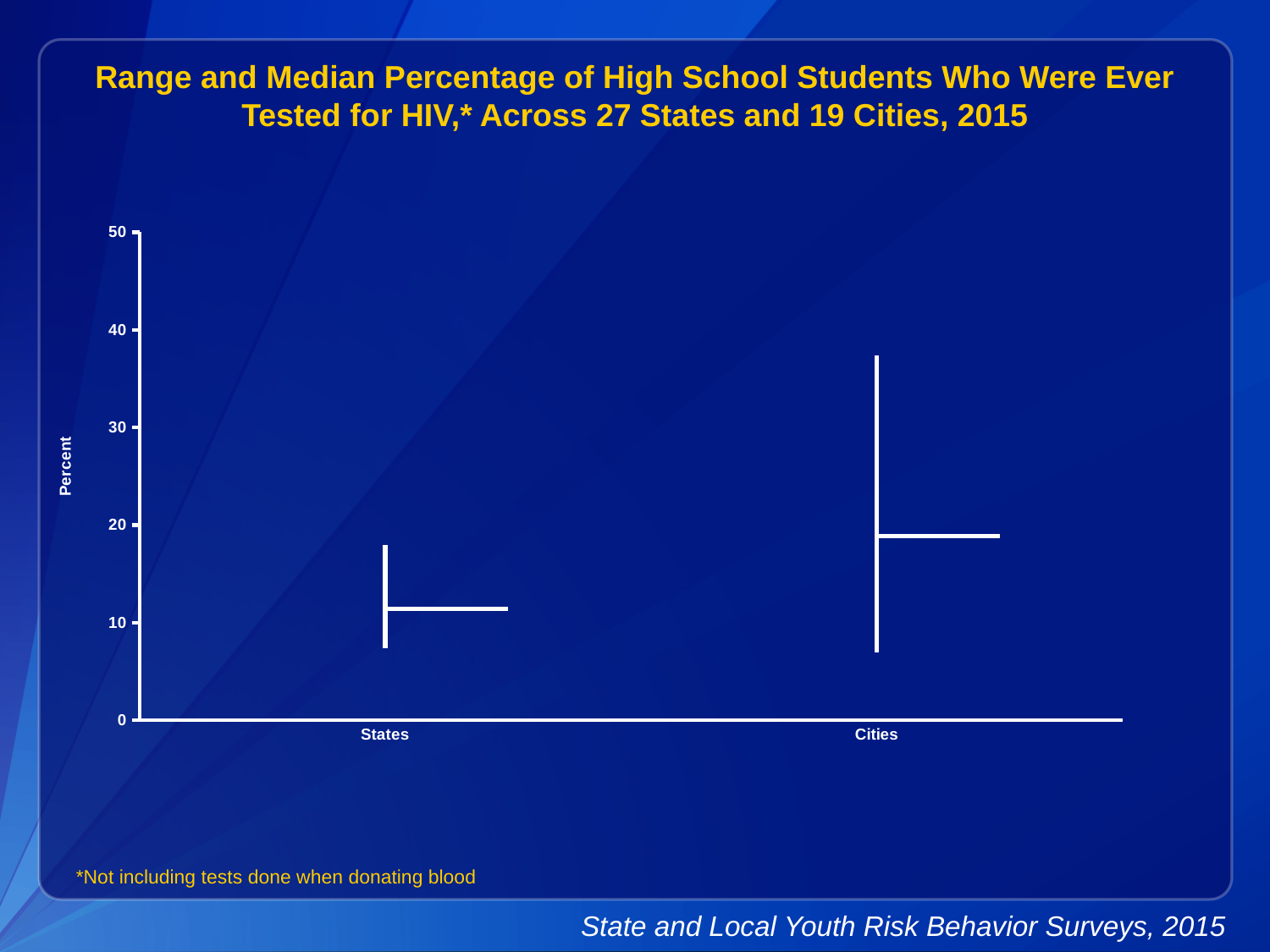
Which category shows the wider range of percentages, States or Cities? Cities Is the median value for Cities greater or less than 30? less Is the top of the range for Cities greater or less than 30? greater Is the median value for Cities greater or less than 10? greater How many categories are shown on the x axis of the chart? 2 What is the maximum value shown on the y axis? 50 What is the label on the y axis of the chart? Percent Which category has the higher median percentage, States or Cities? Cities What are the two categories shown on the x axis? States and Cities